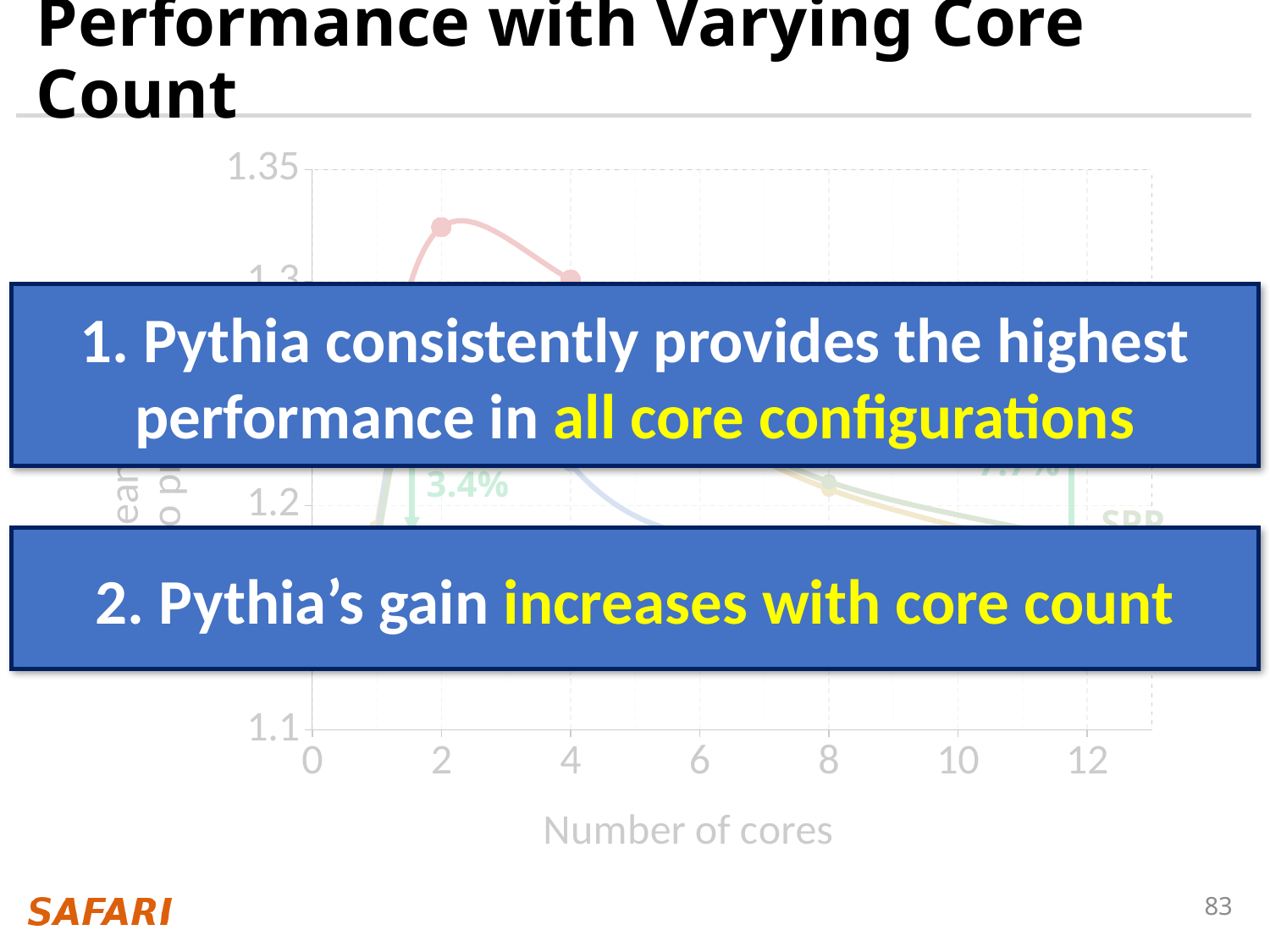
What is the title of the slide containing the chart? Performance with Varying Core Count What kind of chart is shown on the slide? line chart What is the label of the x axis of the chart? Number of cores Does the red line rise or fall between 2 cores and 4 cores? fall Is the value of the red line at 2 cores greater or less than 1.3? greater